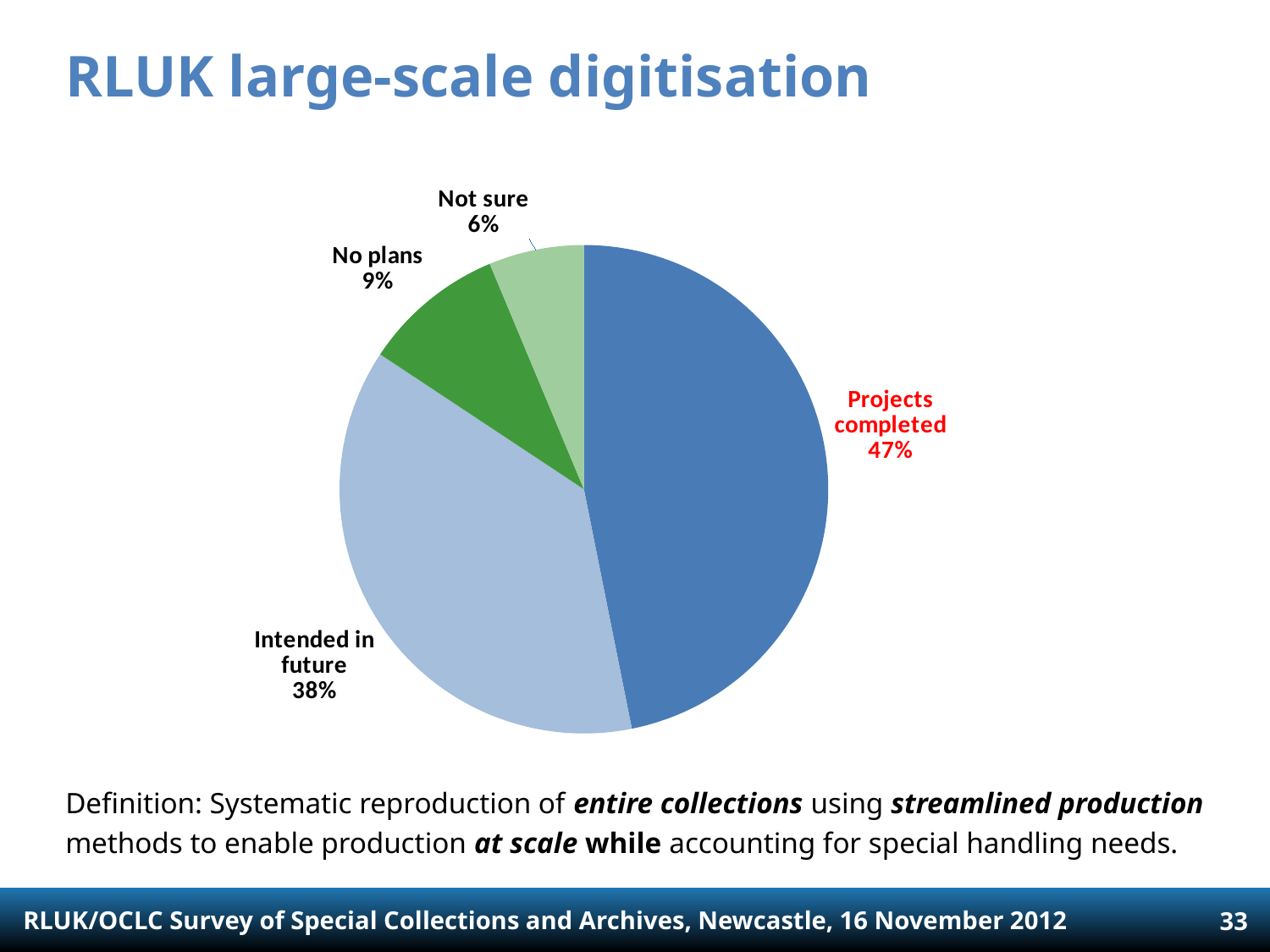
What percentage of the pie is 'Projects completed'? 47% Which slice label is shown in red text? Projects completed How many slices does the pie chart have? 4 What is the combined share of 'No plans' and 'Not sure'? 15% Which is larger, 'No plans' or 'Not sure'? No plans What percentage of the pie is 'Intended in future'? 38% What percentage of the pie is 'Not sure'? 6% What kind of chart is shown on the slide? pie chart What is the difference in percentage points between 'Projects completed' and 'Intended in future'? 9 Which slice of the pie is the largest? Projects completed Which slice of the pie is the smallest? Not sure What percentage of the pie is 'No plans'? 9%